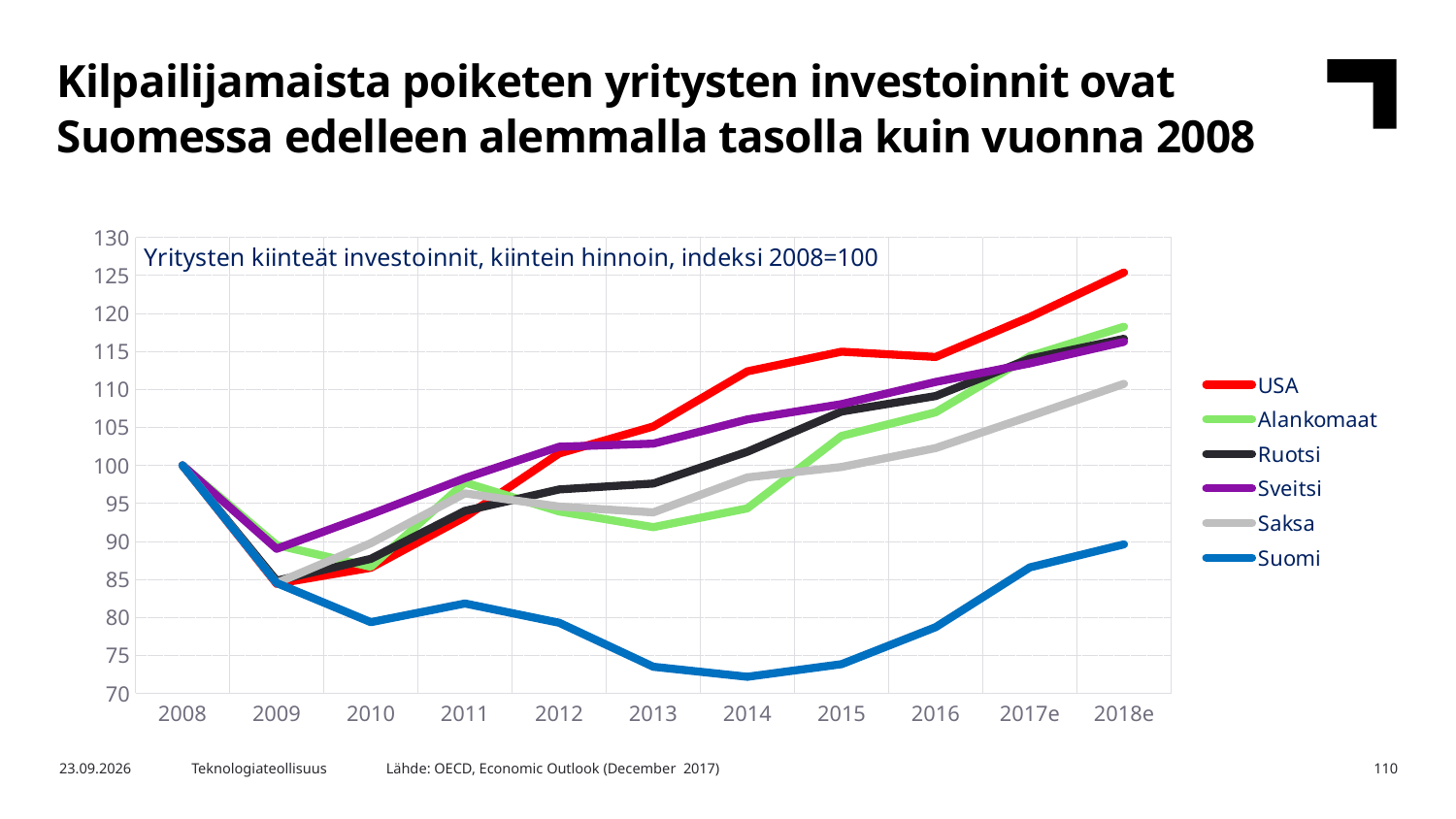
Is the value for Suomi in 2014 greater or less than 75? less Is the value for Alankomaat in 2013 greater or less than 95? less How many years are shown on the x axis? 11 Which country has the highest index value in 2014? USA Does the Suomi line rise or fall from 2008 to 2014? fall What is the title printed inside the chart area? Yritysten kiinteät investoinnit, kiintein hinnoin, indeksi 2008=100 What is the index value for Suomi in 2008? 100 Which country has the highest index value in 2018e? USA What kind of chart is shown on the slide? line chart Which country has the lowest index value in 2018e? Suomi Is the value for USA in 2018e greater or less than 120? greater How many series does the legend list? 6